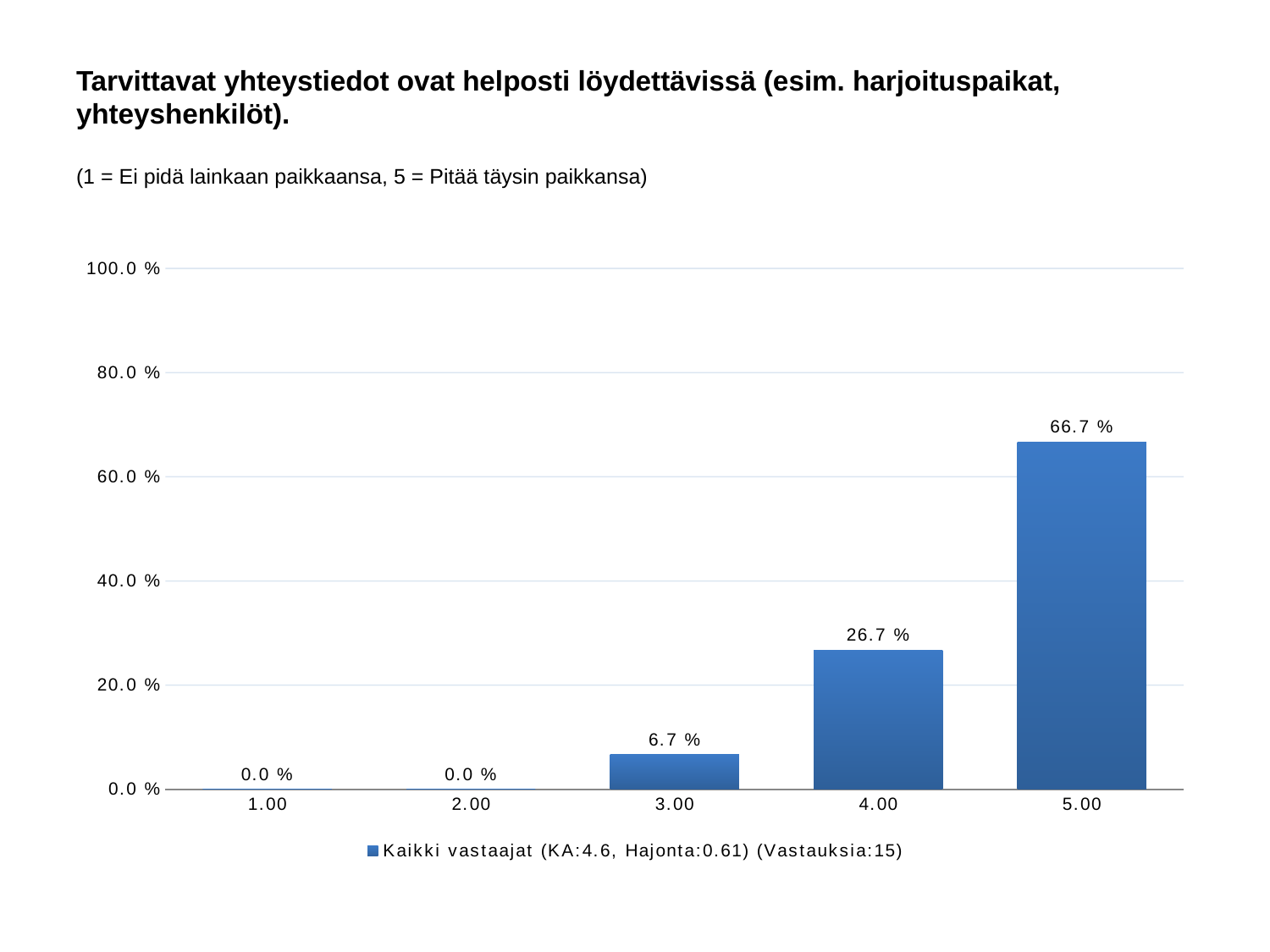
Which is larger, the value for 3.00 or the value for 4.00? 4.00 What is the value for category 5.00? 66.7 % How many responses (Vastauksia) does the legend entry report? 15 How many categories are shown on the x axis? 5 What is the value for category 4.00? 26.7 % What is the difference between the values for 4.00 and 3.00? 20.0 % What kind of chart is shown on the slide? bar chart Is the value for 5.00 greater or less than 60.0 %? greater Which category has the highest value? 5.00 What is the value for category 1.00? 0.0 % What is the difference between the values for 5.00 and 4.00? 40.0 % What is the value for category 3.00? 6.7 %